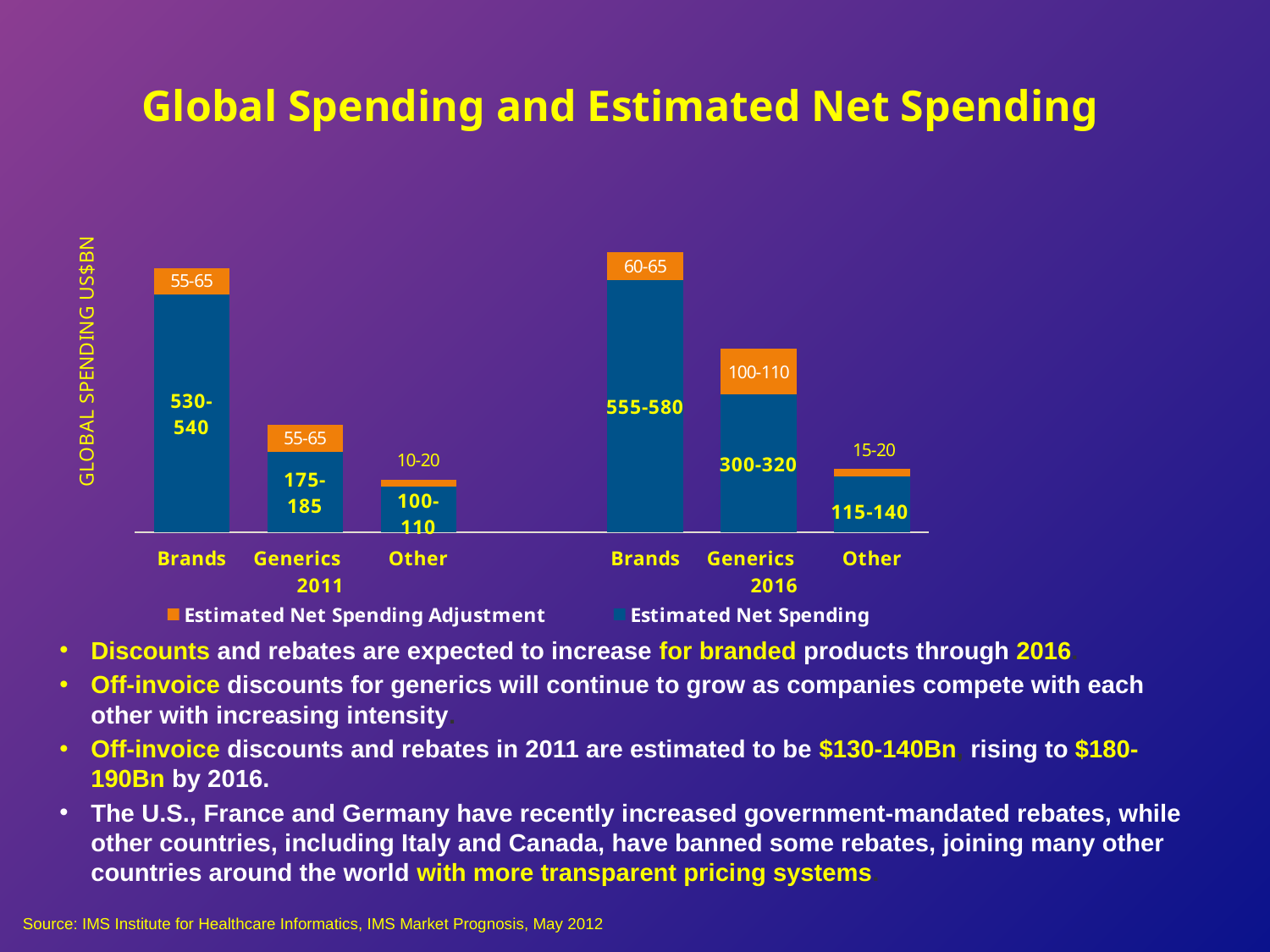
What is the label on the vertical axis of the chart? GLOBAL SPENDING US$BN What is the Estimated Net Spending Adjustment value for Other in 2011? 10-20 What is the Estimated Net Spending value for Other in 2016? 115-140 Which is larger, the Estimated Net Spending for Generics in 2016 or for Generics in 2011? Generics in 2016 What is the Estimated Net Spending Adjustment value for Generics in 2016? 100-110 What is the Estimated Net Spending value for Generics in 2011? 175-185 How many series does the legend list? 2 What kind of chart is shown on the slide? Stacked bar chart How many bars are plotted in the chart? 6 What is the Estimated Net Spending value for Brands in 2011? 530-540 Which category has the lowest Estimated Net Spending Adjustment in 2011? Other Which category has the highest Estimated Net Spending in 2016? Brands